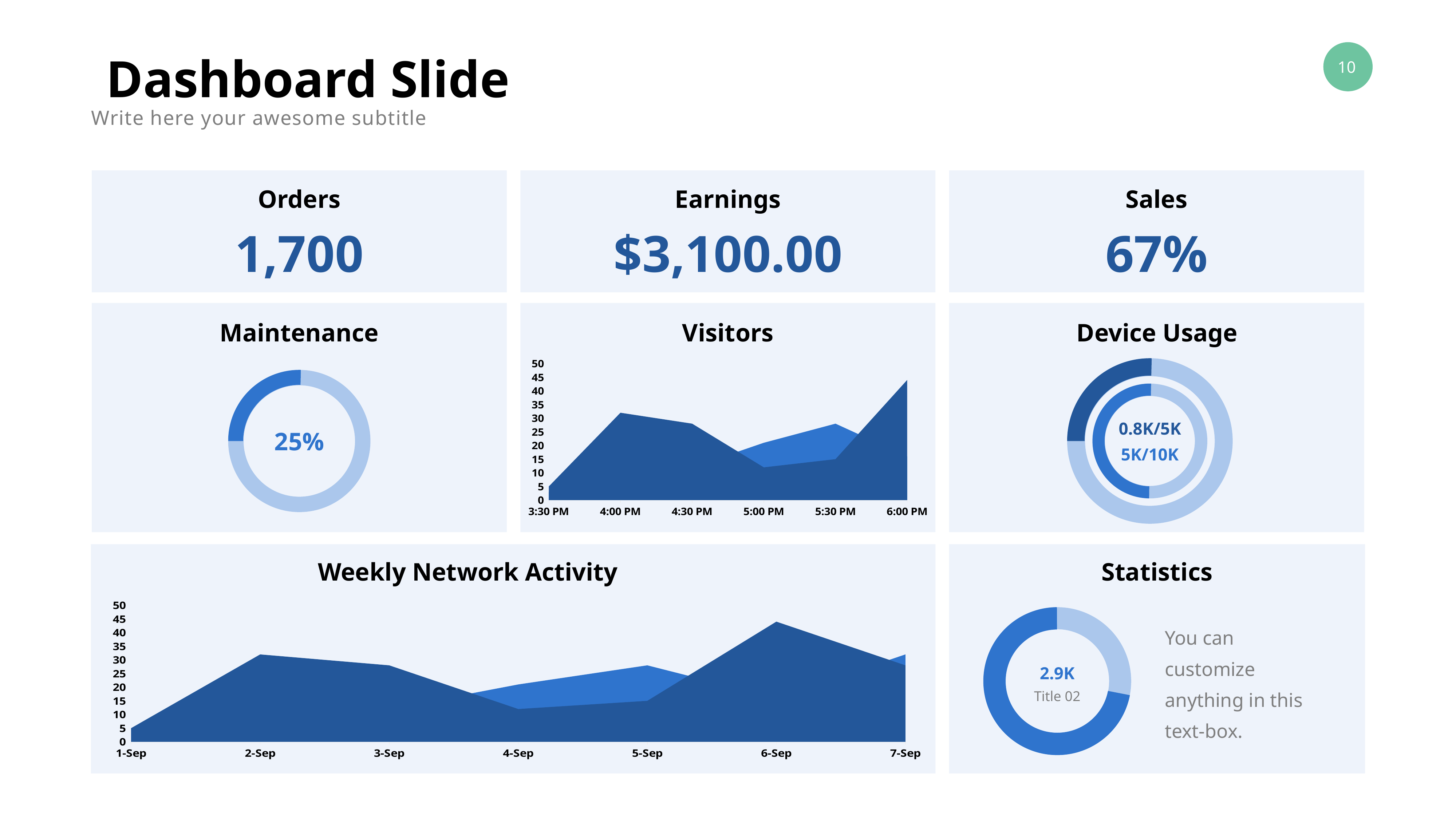
What kind of chart is the Visitors chart? area chart In the Visitors chart, is the value at 3:30 PM greater or less than 10? less What is the second value printed in the centre of the Device Usage chart? 5K/10K What is the title of the chart in the bottom-left panel of the slide? Weekly Network Activity What value is shown in the centre of the Statistics donut chart? 2.9K In the Weekly Network Activity chart, is the value at 6-Sep greater or less than 40? greater What percentage is shown in the centre of the Maintenance donut chart? 25% In the Weekly Network Activity chart, on which date does the plotted area reach its highest point? 6-Sep How many dates are labelled on the x axis of the Weekly Network Activity chart? 7 In the Visitors chart, at which time does the plotted area reach its highest point? 6:00 PM What is the first value printed in the centre of the Device Usage chart? 0.8K/5K How many time points are labelled on the x axis of the Visitors chart? 6